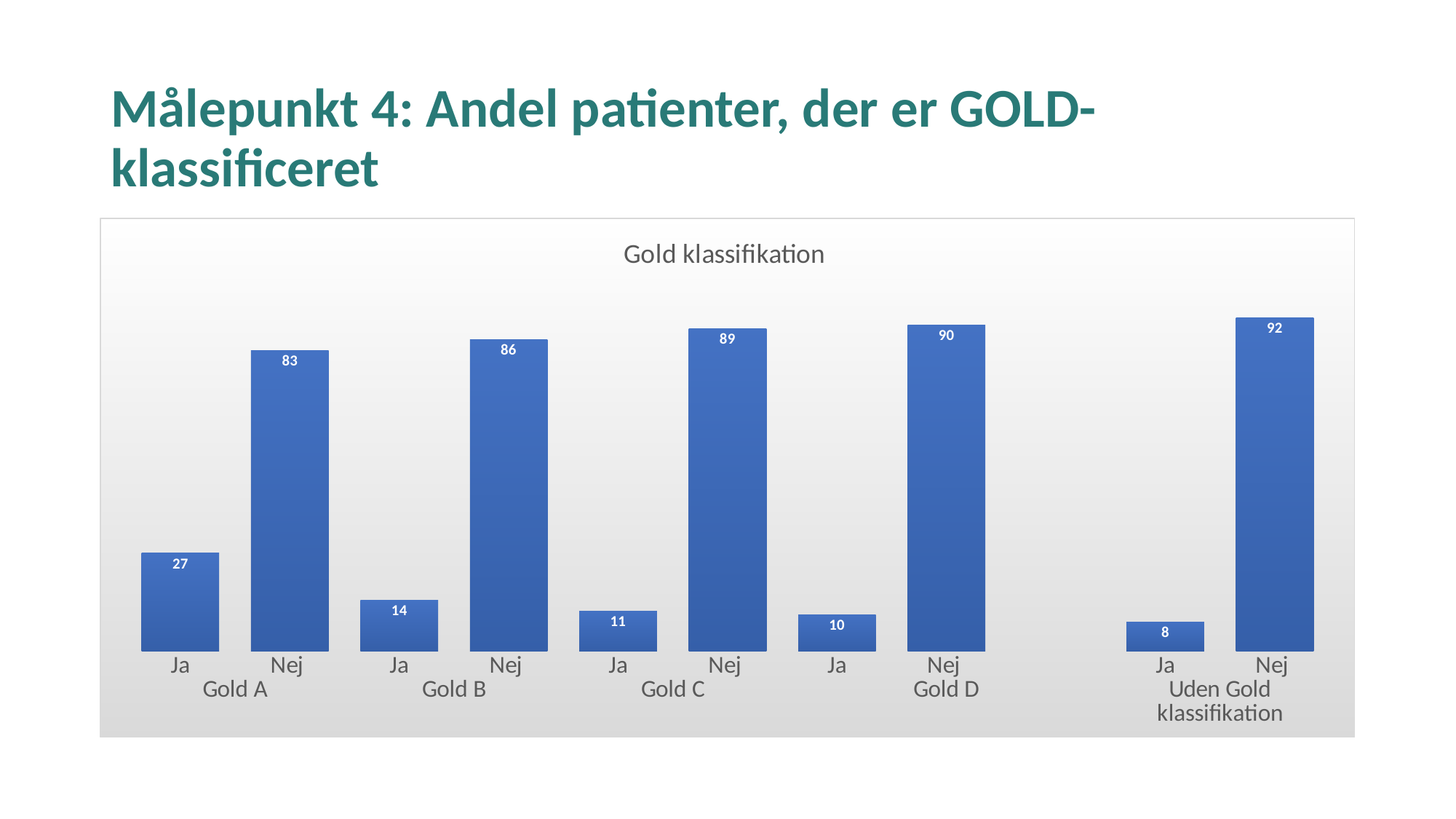
What kind of chart is shown? Bar chart How many bars are plotted in the chart? 10 What is the value for Ja under Gold A? 27 Which bar has the highest value in the chart? Nej, Uden Gold klassifikation Which is larger: Ja under Gold A or Ja under Gold B? Ja under Gold A What is the title of the chart? Gold klassifikation What is the value for Nej under Gold D? 90 What is the value for Ja under Uden Gold klassifikation? 8 What is the difference between Nej and Ja under Gold C? 78 How many groups are shown on the x axis? 5 Which bar has the lowest value in the chart? Ja, Uden Gold klassifikation What is the value for Nej under Gold B? 86